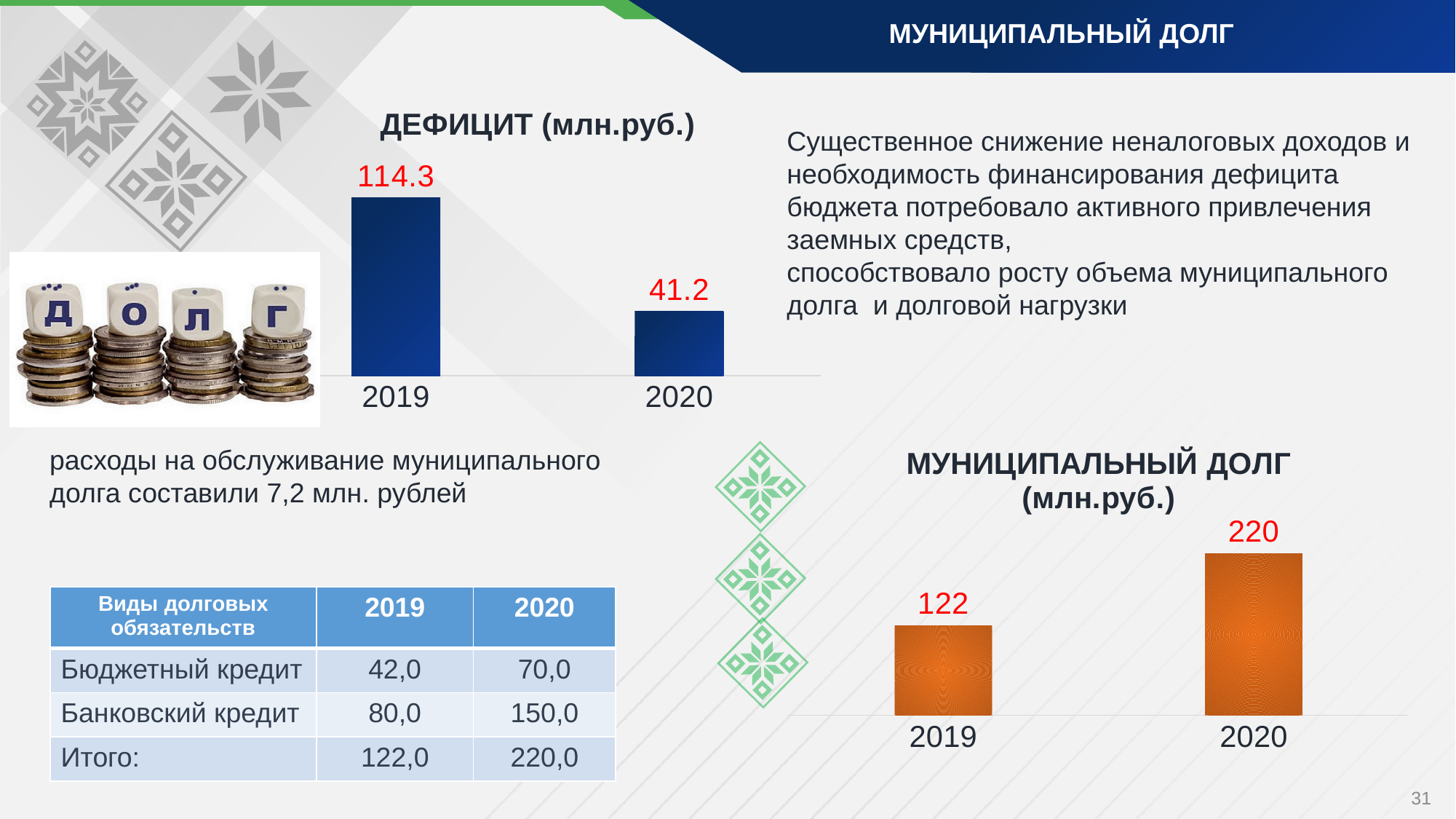
In the chart titled "ДЕФИЦИТ (млн.руб.)", what is the value for 2019? 114.3 In the chart titled "ДЕФИЦИТ (млн.руб.)", which year has the higher value? 2019 In the chart titled "МУНИЦИПАЛЬНЫЙ ДОЛГ (млн.руб.)", which year has the lower value? 2019 In the chart titled "ДЕФИЦИТ (млн.руб.)", what is the value for 2020? 41.2 How many bars does the chart titled "МУНИЦИПАЛЬНЫЙ ДОЛГ (млн.руб.)" have? 2 In the chart titled "ДЕФИЦИТ (млн.руб.)", what is the difference between the 2019 and 2020 values? 73.1 In the chart titled "МУНИЦИПАЛЬНЫЙ ДОЛГ (млн.руб.)", do the values rise or fall from 2019 to 2020? rise In the chart titled "МУНИЦИПАЛЬНЫЙ ДОЛГ (млн.руб.)", what is the value for 2020? 220 In the chart titled "МУНИЦИПАЛЬНЫЙ ДОЛГ (млн.руб.)", by how much does the 2020 value exceed the 2019 value? 98 In the chart titled "МУНИЦИПАЛЬНЫЙ ДОЛГ (млн.руб.)", what is the value for 2019? 122 In the chart titled "ДЕФИЦИТ (млн.руб.)", do the values rise or fall from 2019 to 2020? fall What kind of chart is the "ДЕФИЦИТ (млн.руб.)" chart? bar chart